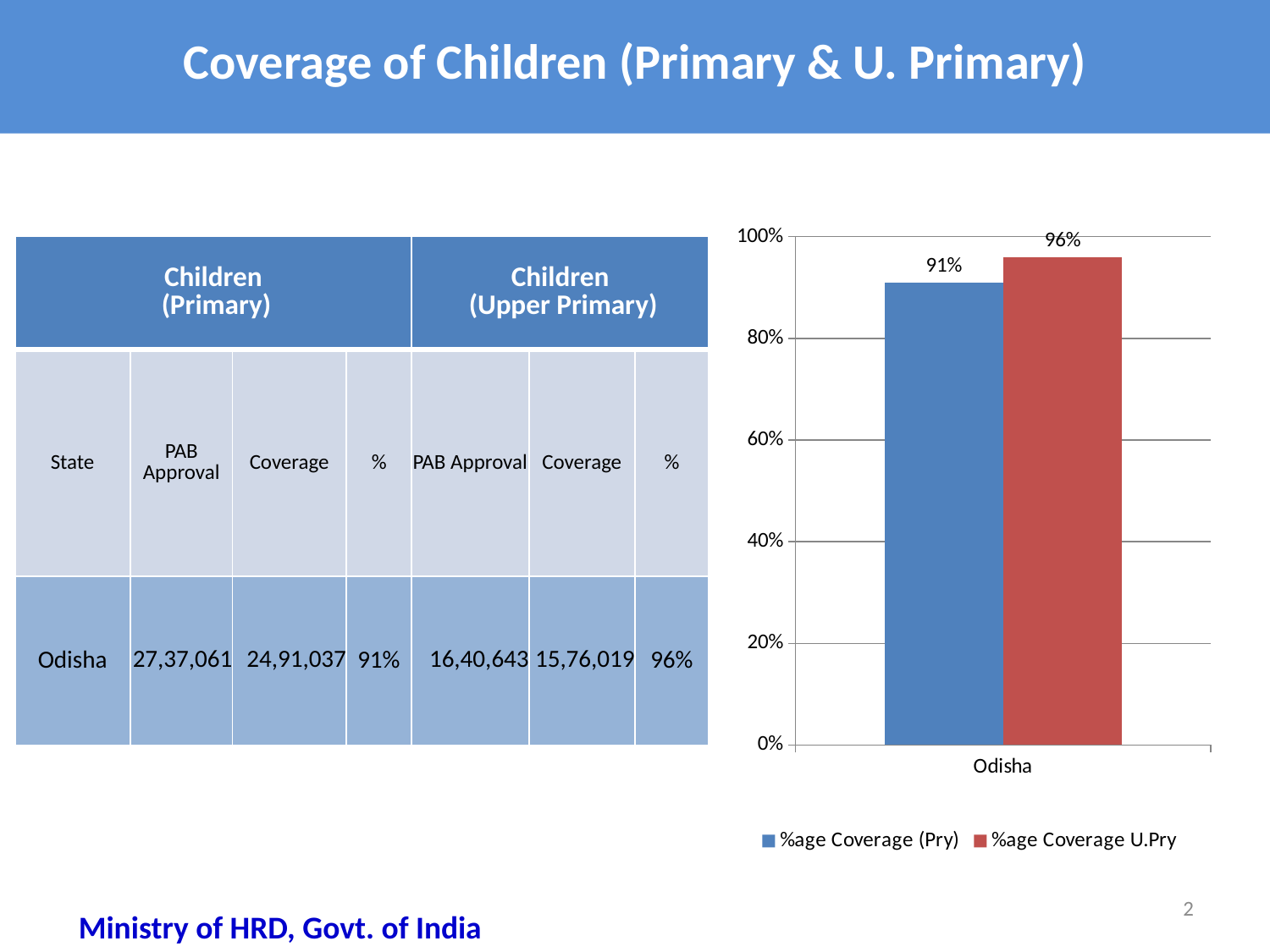
How many series does the chart legend list? 2 Which series has the lower value for Odisha in the chart? %age Coverage (Pry) What is the value of %age Coverage (Pry) for Odisha in the chart? 91% What is the value of %age Coverage U.Pry for Odisha in the chart? 96% Which series has the higher value for Odisha in the chart? %age Coverage U.Pry What colour is the %age Coverage U.Pry bar in the chart? red Is the value for %age Coverage (Pry) for Odisha greater or less than 80%? greater What is the difference between %age Coverage U.Pry and %age Coverage (Pry) for Odisha in the chart? 5% What is the highest value shown on the y axis of the chart? 100% Is %age Coverage (Pry) or %age Coverage U.Pry larger for Odisha in the chart? %age Coverage U.Pry What kind of chart is shown on the slide? bar chart How many categories are shown on the x axis of the chart? 1